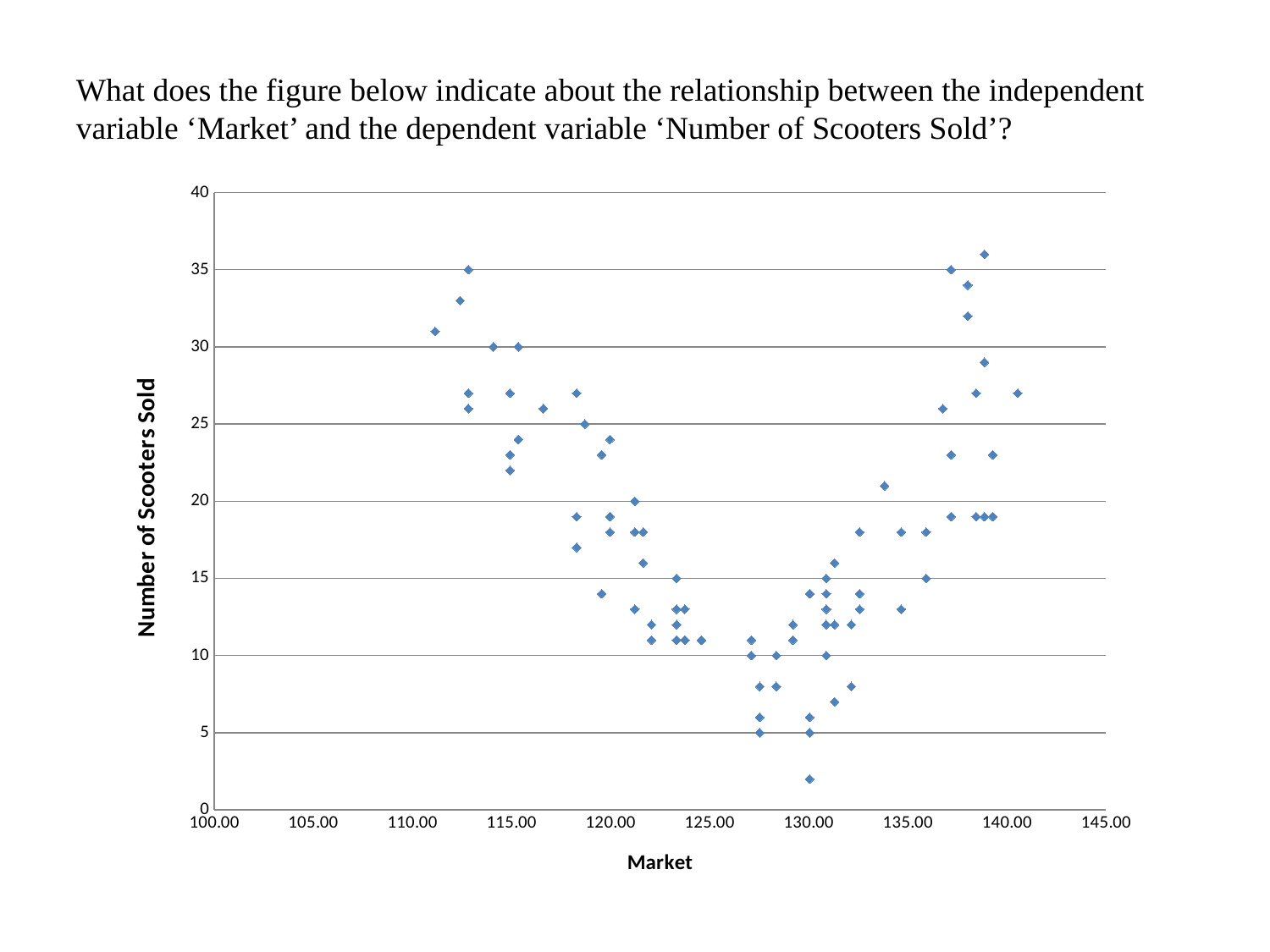
As Market increases from about 130 to about 140, do the values of Number of Scooters Sold generally rise or fall? rise What kind of chart is shown on the slide? scatter chart What is the title of the vertical axis of the chart? Number of Scooters Sold Is the lowest plotted value of Number of Scooters Sold greater or less than 5? less Is the Number of Scooters Sold for the point with the largest Market value greater or less than 25? greater As Market increases from about 110 to about 130, do the values of Number of Scooters Sold generally rise or fall? fall What is the title of the horizontal axis of the chart? Market Is the Number of Scooters Sold for the point with the smallest Market value greater or less than 25? greater What overall pattern do the plotted points follow as Market increases across the chart? fall then rise (U-shaped)